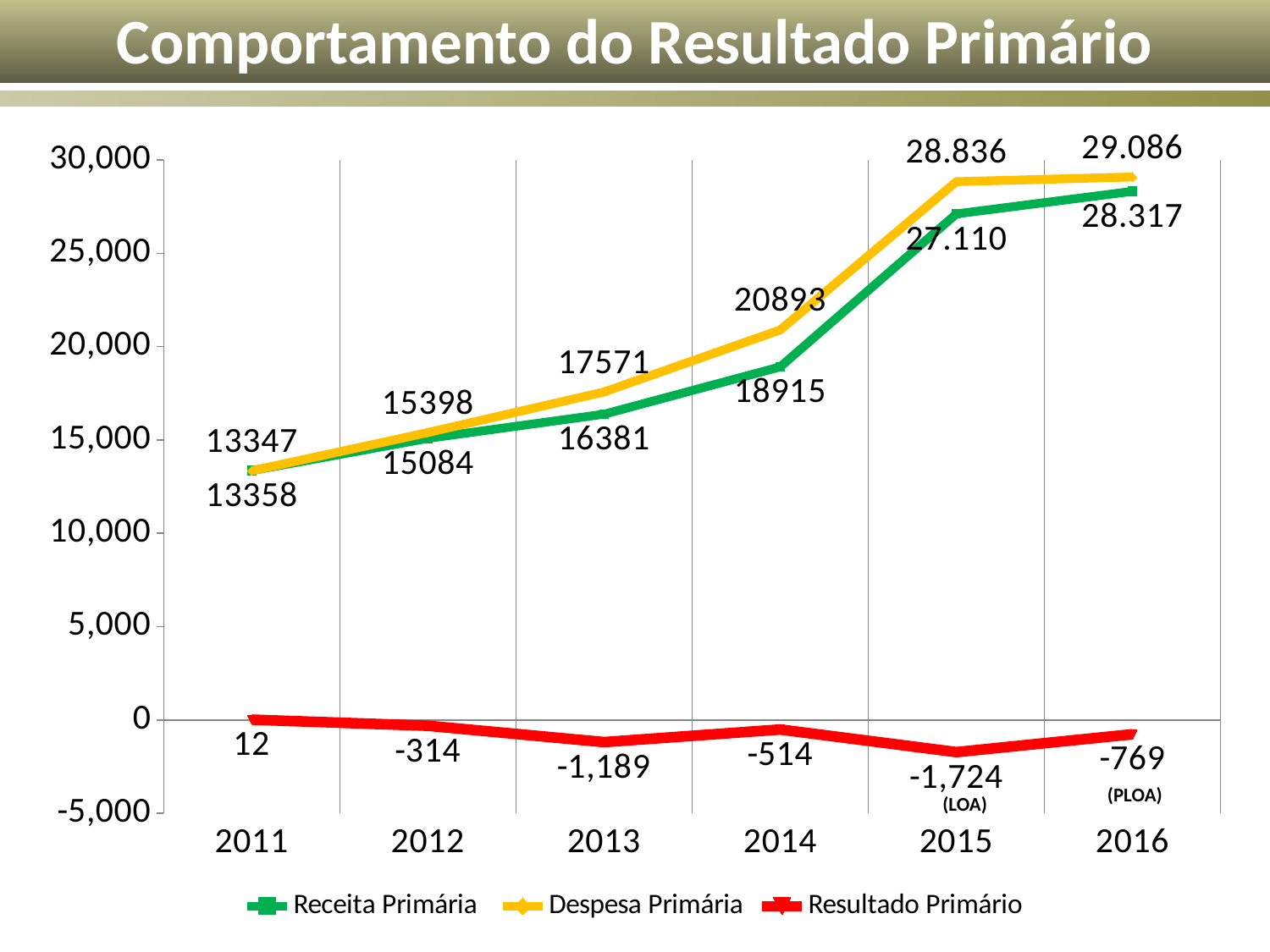
In which year is Resultado Primário lowest? 2015 What is the value of Receita Primária in 2013? 16381 What is the value of Resultado Primário in 2015? -1,724 What type of chart is shown on the slide? Line chart How many series does the legend list? 3 In which year is Resultado Primário highest? 2011 What is the value of Despesa Primária in 2016? 29.086 In 2016, which is larger: Despesa Primária or Receita Primária? Despesa Primária What is the difference between Despesa Primária and Receita Primária in 2013? 1190 Does Despesa Primária rise or fall from 2011 to 2016? Rises How many years are shown on the x axis? 6 What is the value of Despesa Primária in 2014? 20893